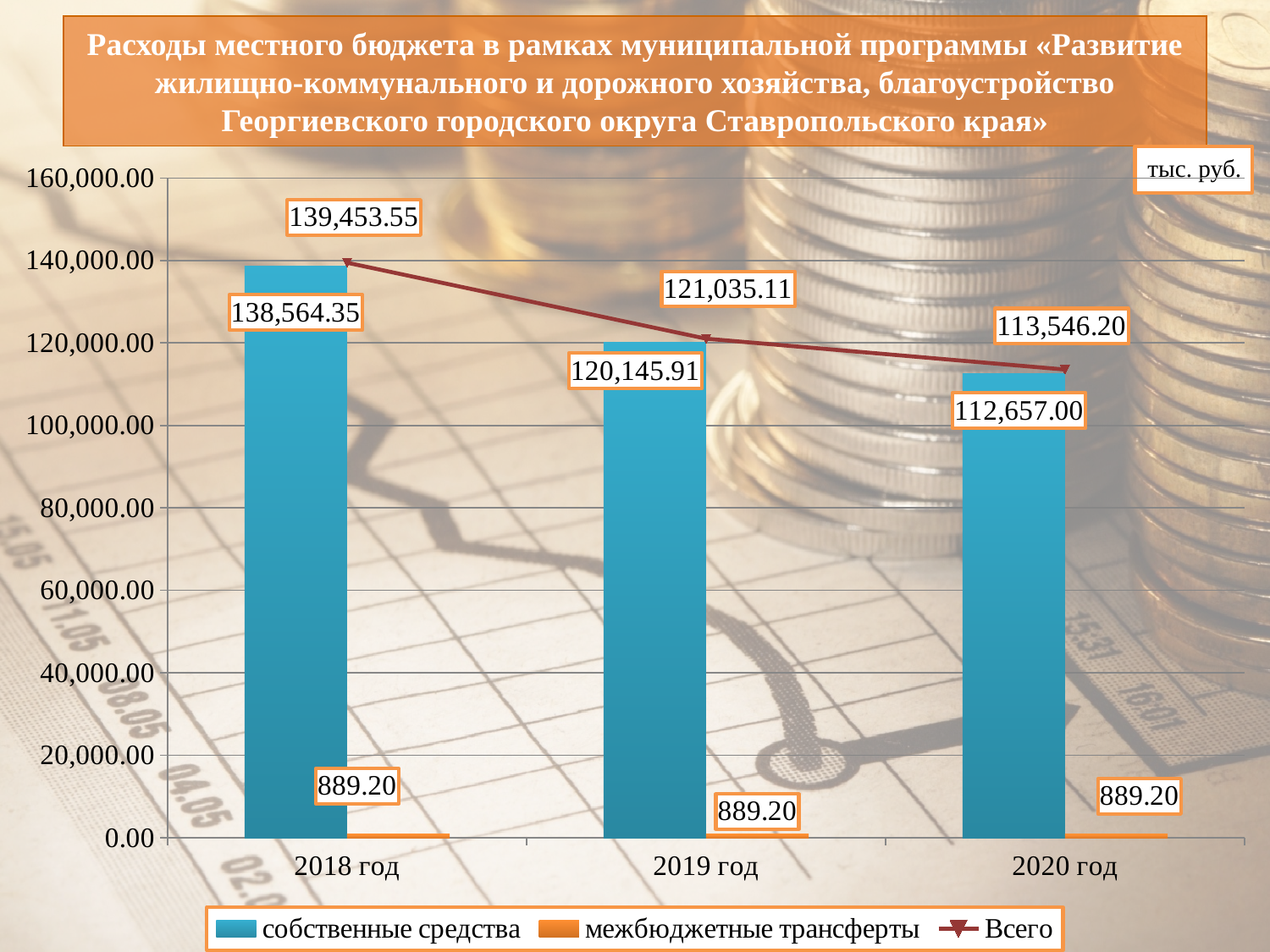
Which is larger: «собственные средства» for 2019 год or for 2020 год? 2019 год What is the value of «собственные средства» for 2020 год? 112,657.00 How many years are shown on the x axis? 3 What is the difference between «Всего» for 2018 год and 2019 год? 18,418.44 In which year is «собственные средства» the lowest? 2020 год What unit of measurement is indicated in the top right corner of the chart? тыс. руб. How many series does the legend list? 3 In which year is «Всего» the highest? 2018 год What is the value of «собственные средства» for 2018 год? 138,564.35 Does «Всего» rise or fall from 2018 год to 2020 год? fall What is the value of «межбюджетные трансферты» for 2020 год? 889.20 What is the value of «Всего» for 2019 год? 121,035.11